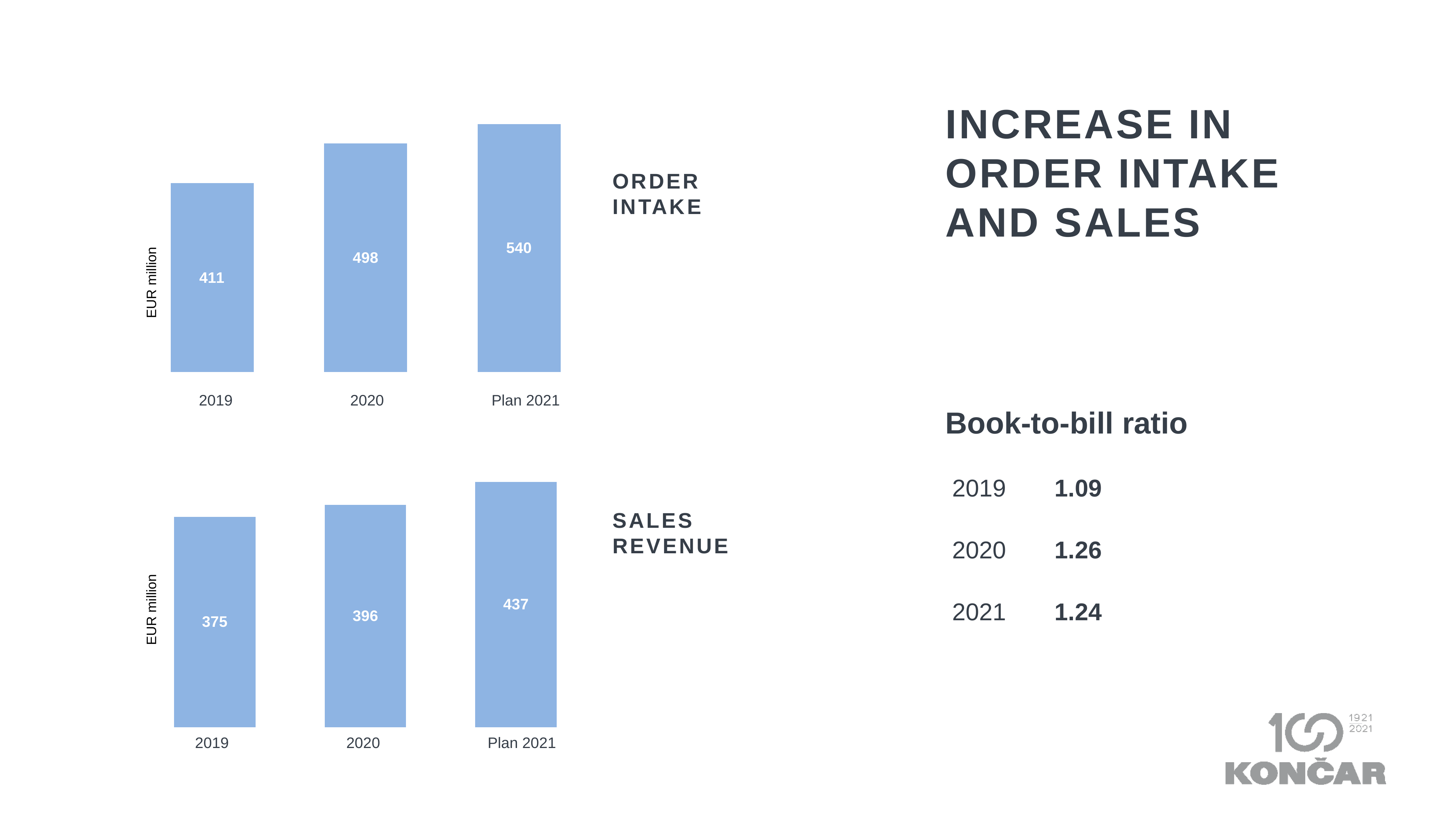
In the Sales Revenue chart, what is the difference between the 2020 value and the 2019 value? 21 What kind of chart is the Order Intake chart? Bar chart In the Order Intake chart, which category has the lowest value? 2019 In the Sales Revenue chart, what is the value for Plan 2021? 437 In the Order Intake chart, what is the difference between the Plan 2021 value and the 2019 value? 129 In the Sales Revenue chart, which category has the highest value? Plan 2021 In the Order Intake chart, what is the value for 2020? 498 Which is larger: the Order Intake value for 2020 or the Sales Revenue value for 2020? Order Intake for 2020 In the Order Intake chart, what is the value for Plan 2021? 540 In the Sales Revenue chart, what is the value for 2019? 375 How many bars are in the Sales Revenue chart? 3 In the Sales Revenue chart, do the values rise or fall from 2019 to Plan 2021? Rise